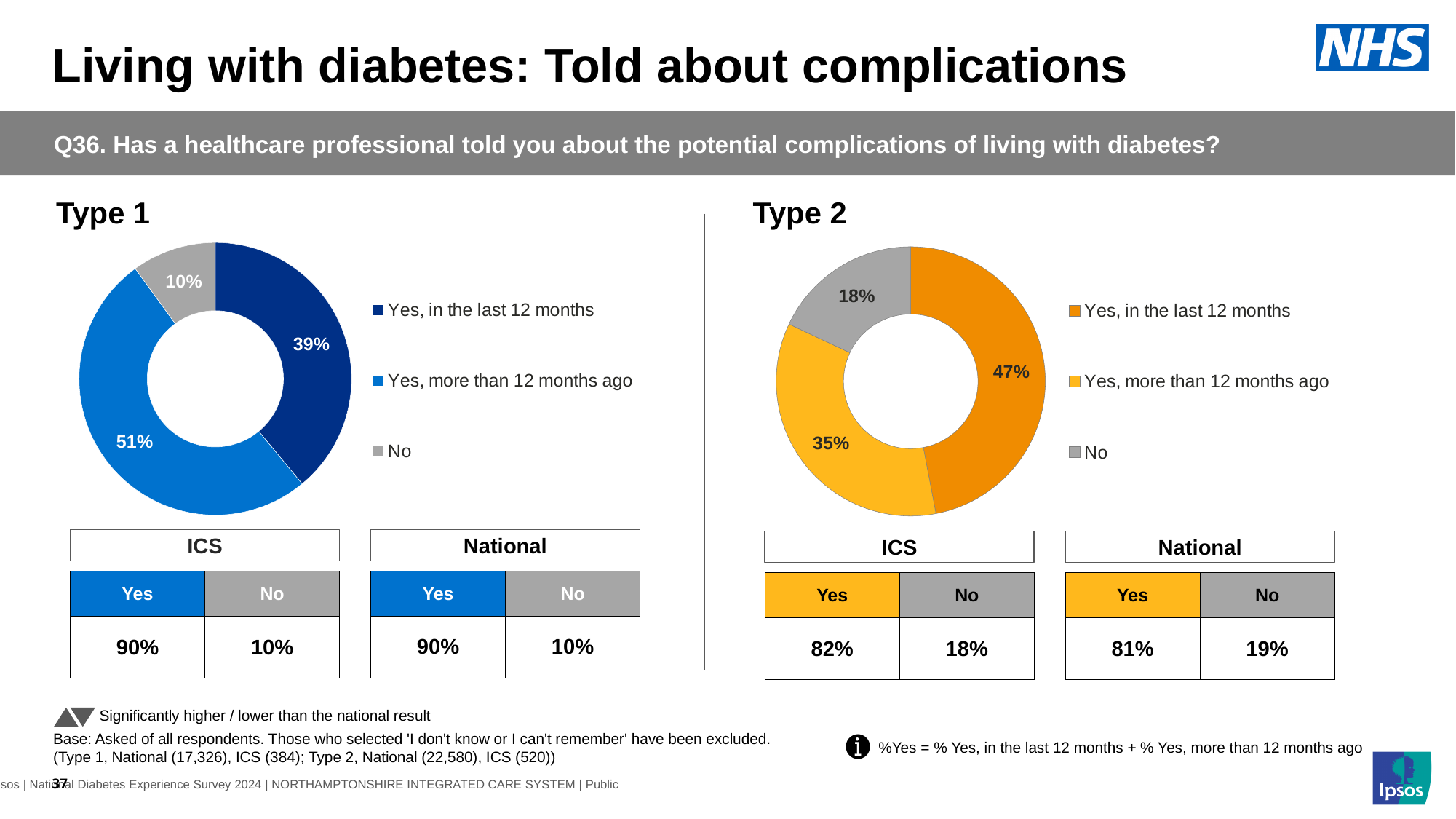
In the Type 2 chart, what is the difference between 'Yes, in the last 12 months' and 'Yes, more than 12 months ago'? 12% In the Type 1 chart, what percentage said 'Yes, in the last 12 months'? 39% In the Type 2 chart, what percentage said 'No'? 18% In the Type 1 chart, what is the combined share of the two 'Yes' categories? 90% In the Type 2 chart, which category has the smallest share? No In the Type 1 chart, what percentage said 'Yes, more than 12 months ago'? 51% In the Type 1 chart, which category has the largest share? Yes, more than 12 months ago In the Type 2 chart, what percentage said 'Yes, in the last 12 months'? 47% What kind of chart is the Type 1 chart? Doughnut chart How many categories does the Type 2 chart show? 3 What colour is the 'No' segment in the Type 2 chart? Grey In the Type 1 chart, which is larger: 'Yes, in the last 12 months' or 'No'? Yes, in the last 12 months